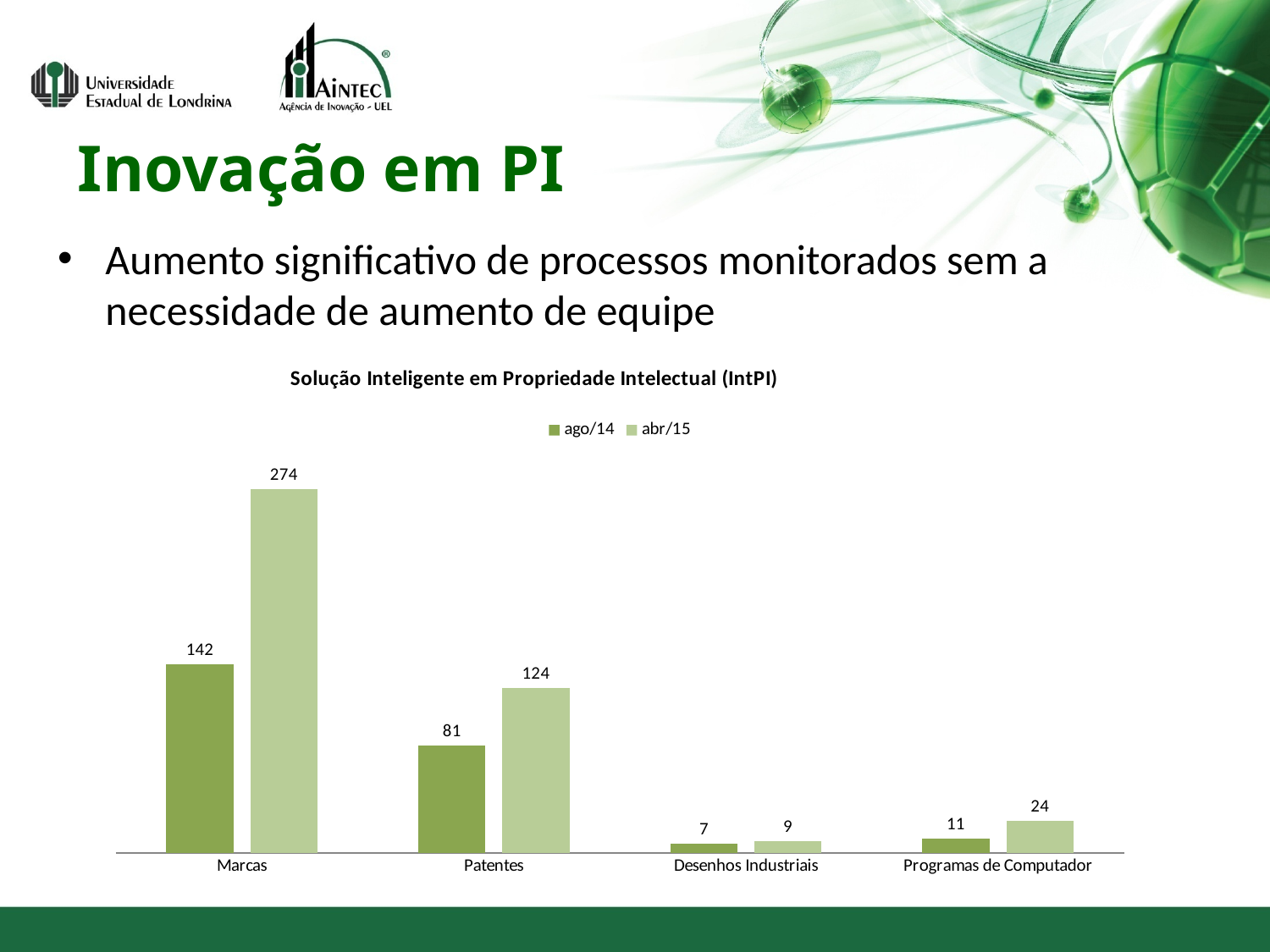
What is the value for Patentes in the ago/14 series? 81 What type of chart is shown on the slide? Bar chart What is the value for Desenhos Industriais in the ago/14 series? 7 What is the value for Marcas in the abr/15 series? 274 Which category has the highest value in the abr/15 series? Marcas How many categories are shown on the x axis? 4 How many series does the legend list? 2 What is the value for Programas de Computador in the abr/15 series? 24 What is the difference between the abr/15 and ago/14 values for Patentes? 43 Which is larger: the ago/14 value for Marcas or the abr/15 value for Patentes? ago/14 value for Marcas What is the difference between the abr/15 and ago/14 values for Marcas? 132 Which category has the lowest value in the ago/14 series? Desenhos Industriais